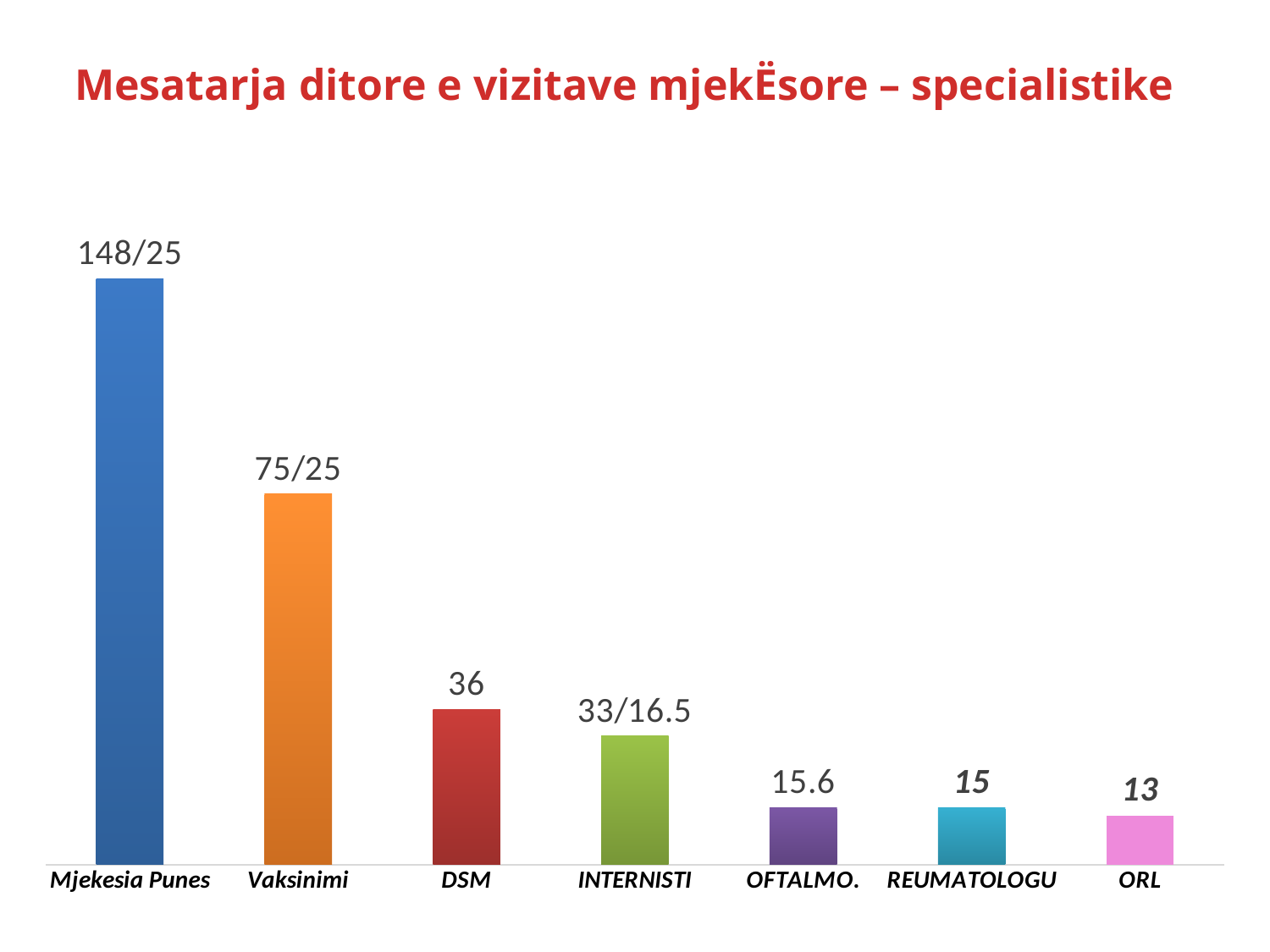
What is the data label shown for Vaksinimi? 75/25 What is the value for ORL? 13 What is the value for DSM? 36 Which category has the tallest bar? Mjekesia Punes Which has a larger value, REUMATOLOGU or ORL? REUMATOLOGU What is the data label shown for INTERNISTI? 33/16.5 Which category has the shortest bar? ORL What is the value for OFTALMO.? 15.6 What is the data label shown for Mjekesia Punes? 148/25 What kind of chart is shown on the slide? Bar chart How many categories are shown in the chart? 7 What is the difference between the values for DSM and OFTALMO.? 20.4